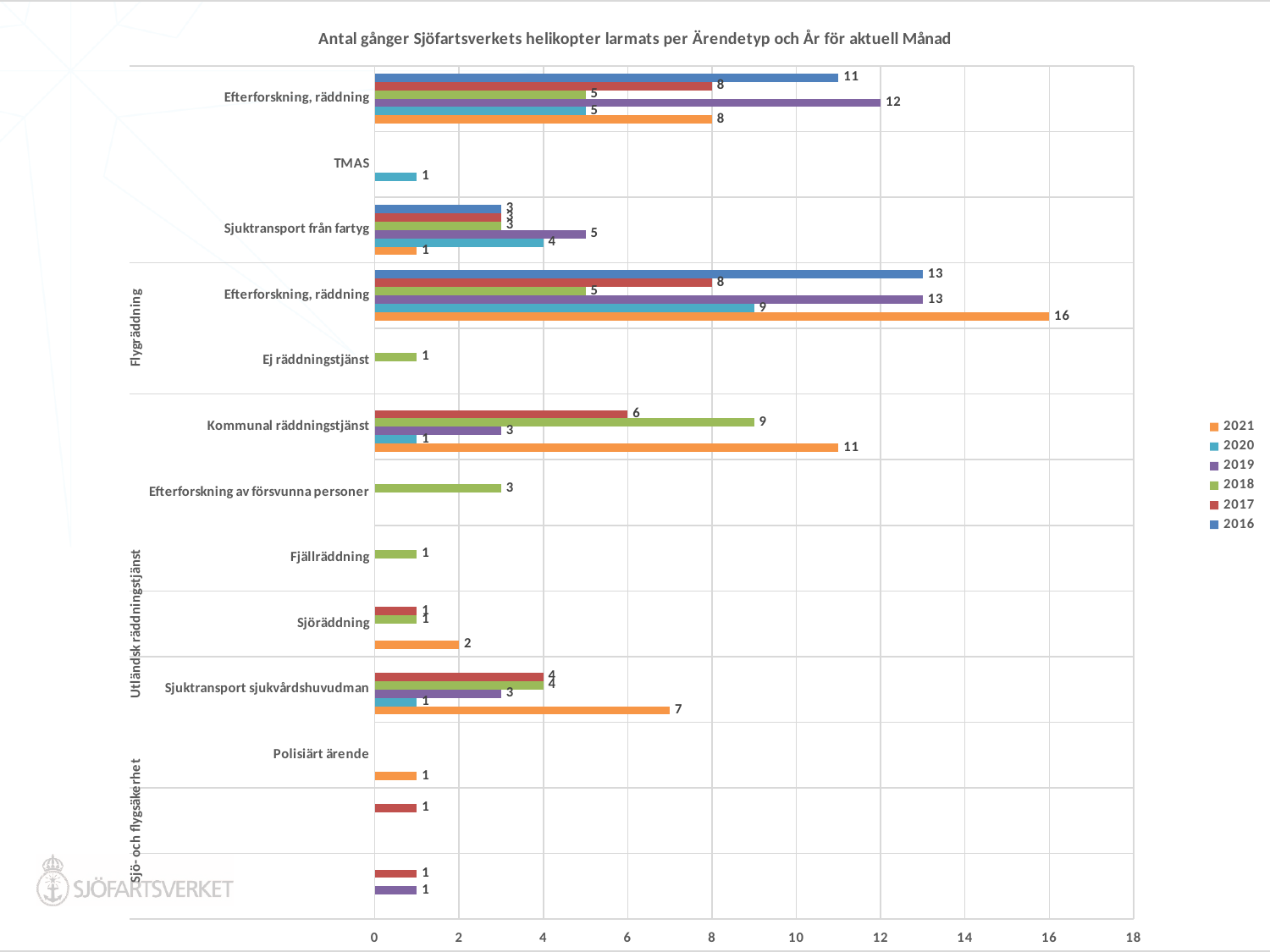
How many series does the legend list? 6 What is the value for 2018 for Kommunal räddningstjänst? 9 What is the value for 2018 for Efterforskning av försvunna personer? 3 What is the difference between the 2021 and 2017 values for Efterforskning, räddning in the Flygräddning group? 8 What is the title of the chart? Antal gånger Sjöfartsverkets helikopter larmats per Ärendetyp och År för aktuell Månad Which year has the lowest value for Sjuktransport från fartyg? 2021 Which year has the highest value for Kommunal räddningstjänst? 2021 What is the value for 2021 for Efterforskning, räddning in the Flygräddning group? 16 What is the value for 2019 for the topmost Efterforskning, räddning category? 12 Which is larger for Sjuktransport från fartyg: the 2019 value or the 2020 value? 2019 What kind of chart is shown on the slide? bar chart What is the value for 2021 for Sjuktransport sjukvårdshuvudman? 7